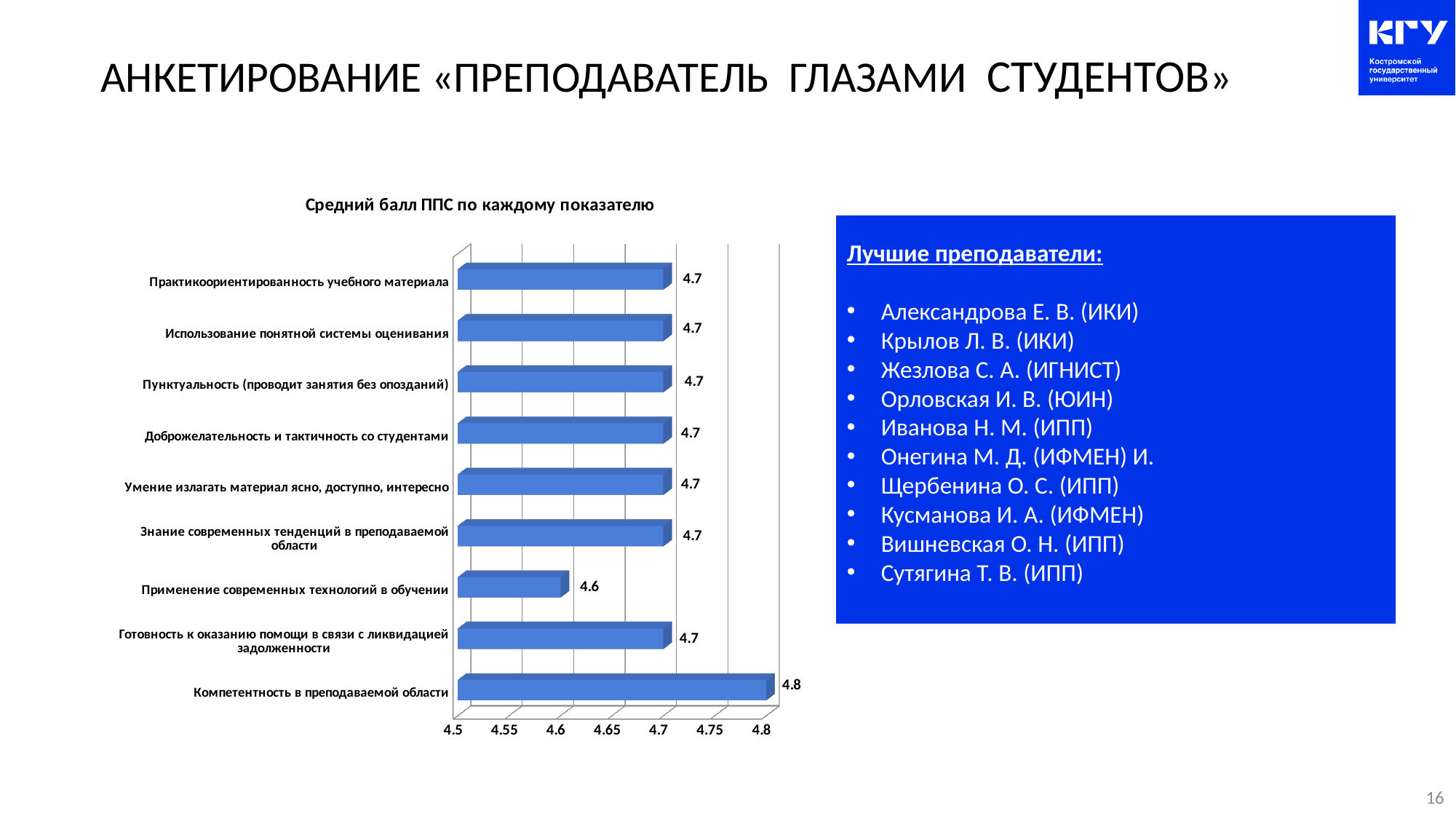
What is the average score for «Компетентность в преподаваемой области»? 4.8 What is the difference between the scores for «Компетентность в преподаваемой области» and «Применение современных технологий в обучении»? 0.2 How many indicators are shown in the chart? 9 Which indicator has the highest average score? Компетентность в преподаваемой области What type of chart is shown on the slide? Bar chart What is the average score for «Готовность к оказанию помощи в связи с ликвидацией задолженности»? 4.7 What is the title of the chart? Средний балл ППС по каждому показателю Which indicator has the lowest average score? Применение современных технологий в обучении What is the average score for «Применение современных технологий в обучении»? 4.6 Which has a lower score: «Применение современных технологий в обучении» or «Умение излагать материал ясно, доступно, интересно»? Применение современных технологий в обучении Which has a higher score: «Компетентность в преподаваемой области» or «Доброжелательность и тактичность со студентами»? Компетентность в преподаваемой области What is the average score for «Пунктуальность (проводит занятия без опозданий)»? 4.7